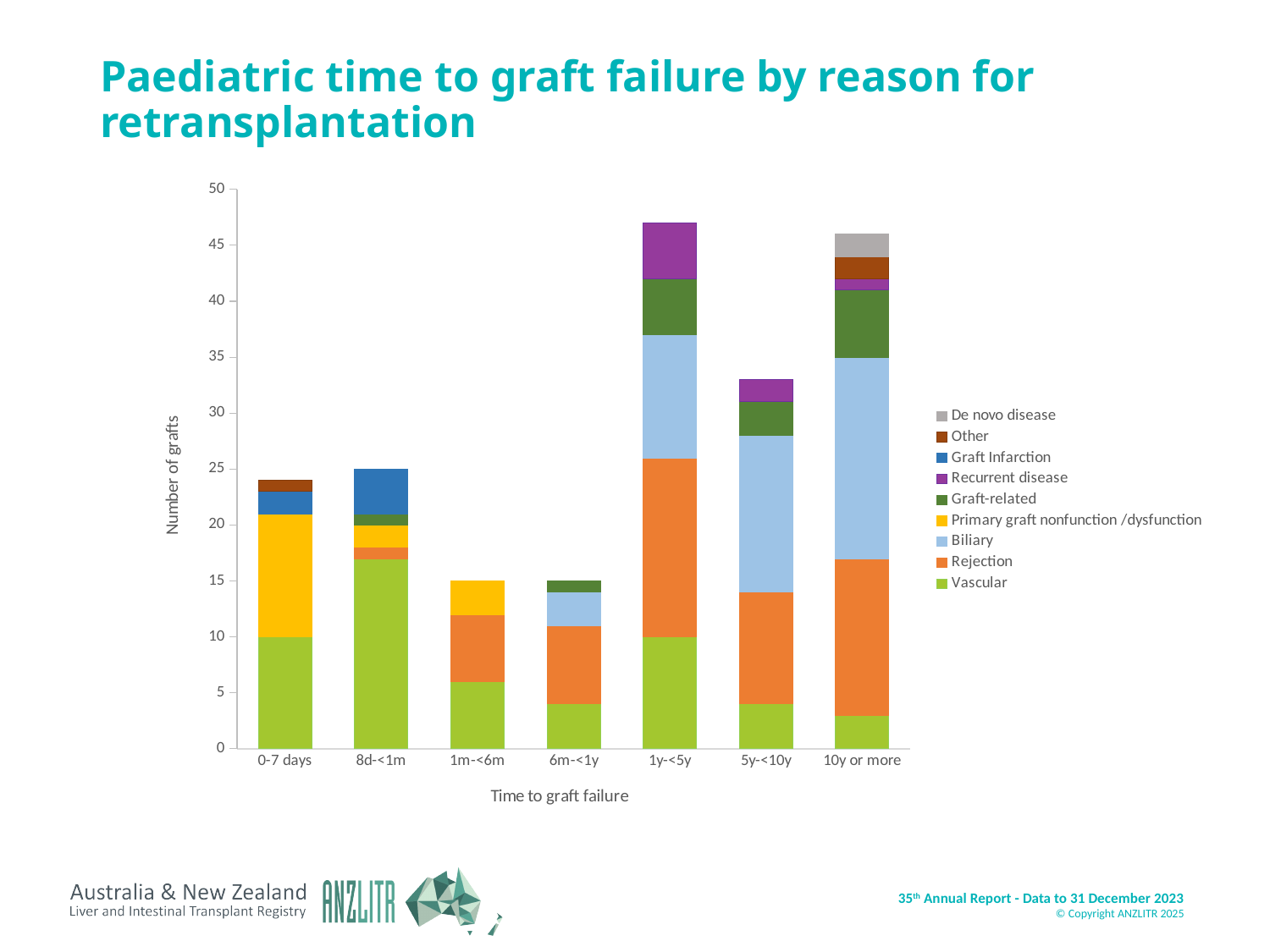
What is the total number of grafts for the 6m-<1y bar? 15 What is the total number of grafts for the 8d-<1m bar? 25 Which bar is taller, 8d-<1m or 1m-<6m? 8d-<1m Is the total for the 5y-<10y bar greater or less than 30? greater What is the label of the y axis? Number of grafts What is the total number of grafts for the 1m-<6m bar? 15 How many Vascular grafts are shown in the 0-7 days bar? 10 How many series does the legend list? 9 What kind of chart is shown on the slide? Stacked bar chart Which bar is taller, 1y-<5y or 5y-<10y? 1y-<5y How many time-to-graft-failure categories are shown on the x axis? 7 Is the total for the 1y-<5y bar greater or less than 45? greater